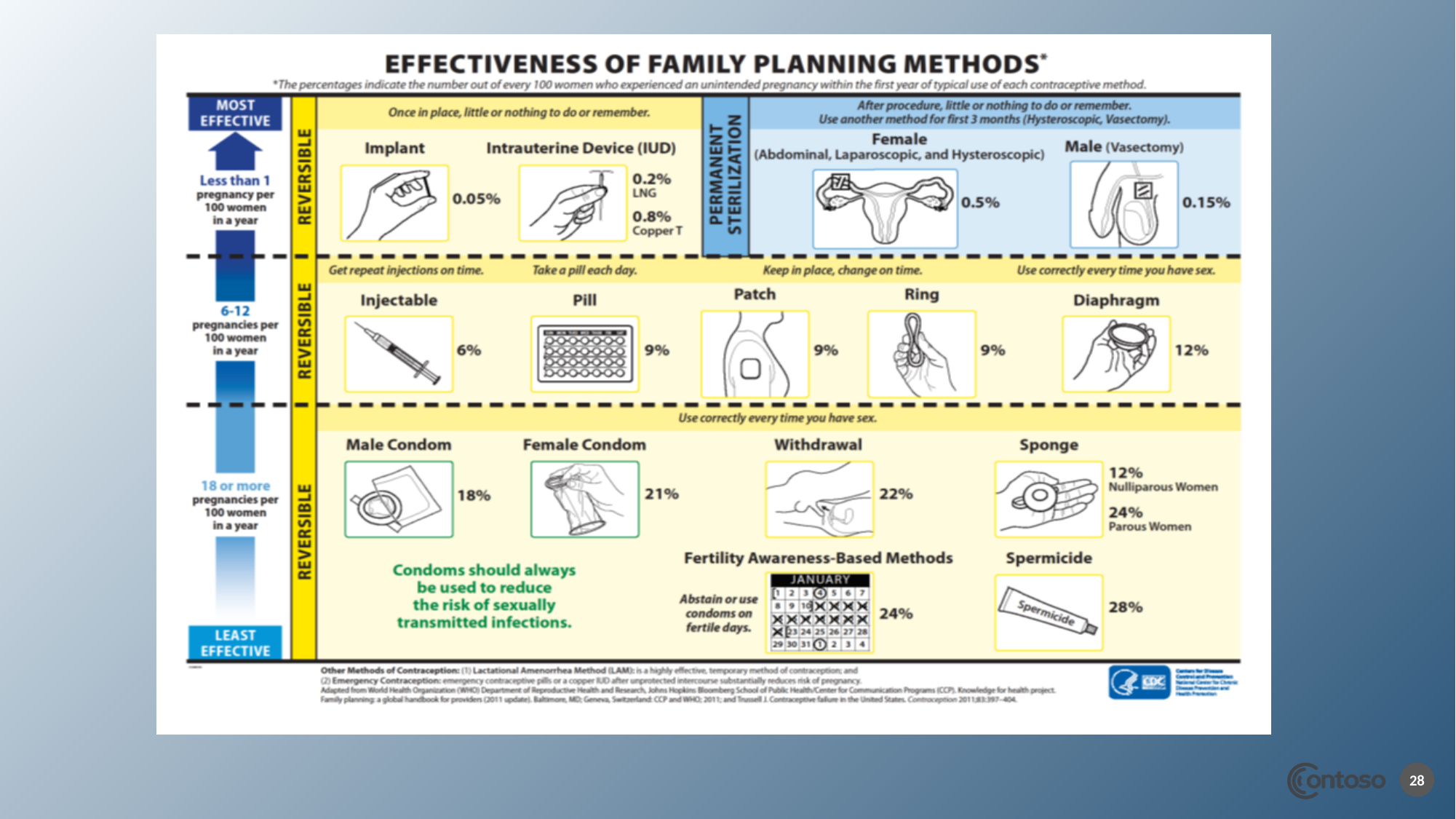
What percentage is shown for the Implant? 0.05% What percentage is shown for Male (Vasectomy) sterilization? 0.15% How many methods are shown in the middle row (6-12 pregnancies per 100 women in a year)? 5 Which has a higher percentage, Female Condom or Injectable? Female Condom What percentage is shown for Spermicide? 28% What percentage is shown for the Diaphragm? 12% Which method has the highest percentage of unintended pregnancies shown? Spermicide What percentage is shown for the Sponge for Parous Women? 24% What is the difference between the percentages for Withdrawal and Male Condom? 4% Which method has the lowest percentage of unintended pregnancies shown? Implant What percentage is shown for the Copper T Intrauterine Device (IUD)? 0.8% What is the title of the infographic on the slide? Effectiveness of Family Planning Methods